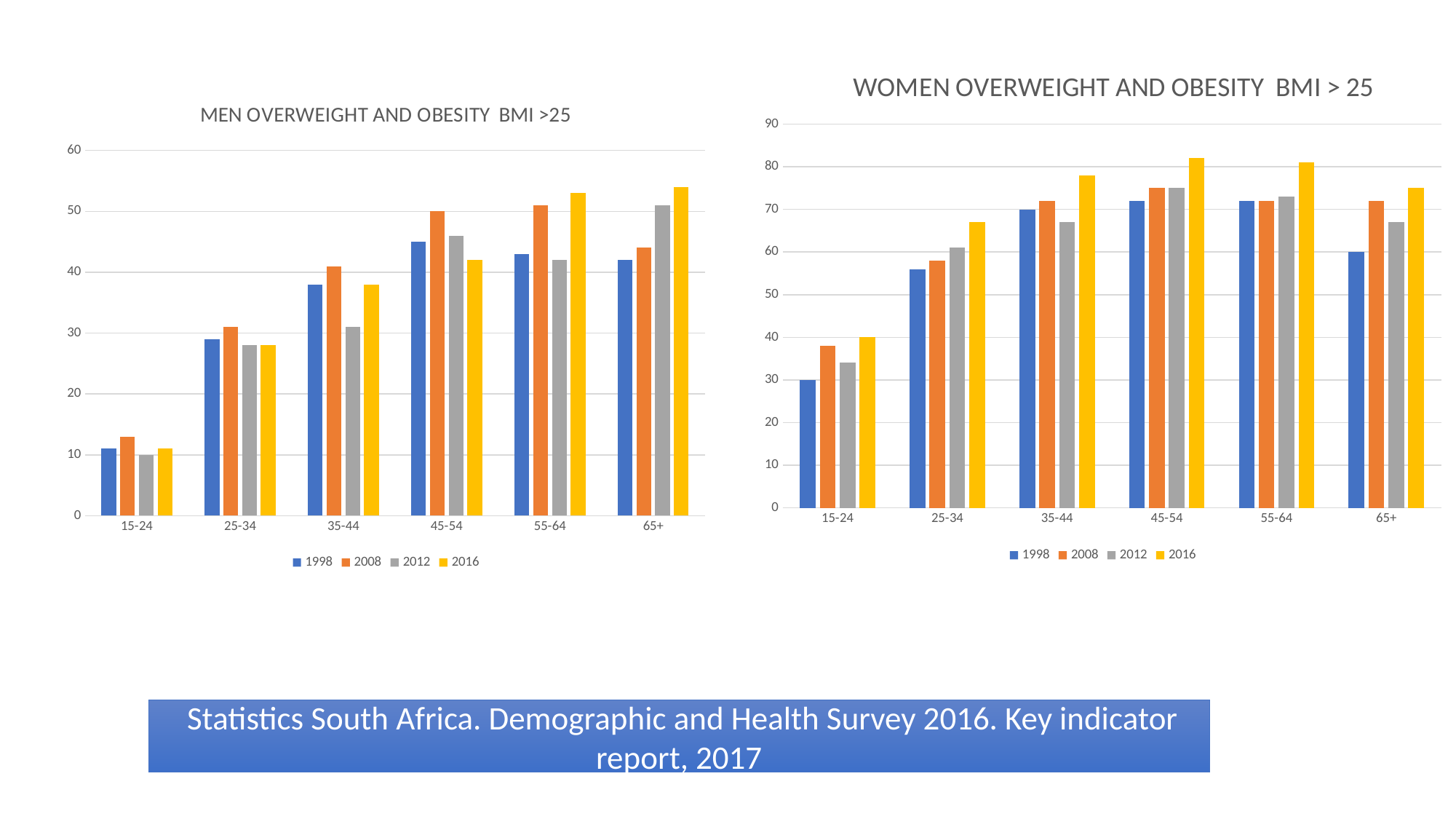
In the WOMEN OVERWEIGHT AND OBESITY BMI > 25 chart, is the 2016 value for 45-54 greater or less than 80? greater How many series does the legend of the WOMEN OVERWEIGHT AND OBESITY BMI > 25 chart list? 4 Which legend entry is shown in yellow on both charts? 2016 In the WOMEN OVERWEIGHT AND OBESITY BMI > 25 chart, which age group has the highest 2016 value? 45-54 In the MEN OVERWEIGHT AND OBESITY BMI >25 chart, which age group has the lowest values across all years? 15-24 How many age-group categories are shown on the x axis of the MEN OVERWEIGHT AND OBESITY BMI >25 chart? 6 In the MEN OVERWEIGHT AND OBESITY BMI >25 chart, is the 2012 value for 35-44 greater or less than 40? less What type of chart is the MEN OVERWEIGHT AND OBESITY BMI >25 chart? bar chart In the WOMEN OVERWEIGHT AND OBESITY BMI > 25 chart, which is larger for the 65+ age group: the 1998 value or the 2016 value? 2016 In the MEN OVERWEIGHT AND OBESITY BMI >25 chart, which is larger for the 45-54 age group: the 2008 value or the 2016 value? 2008 In the WOMEN OVERWEIGHT AND OBESITY BMI > 25 chart, is the 1998 value for 15-24 greater or less than 40? less